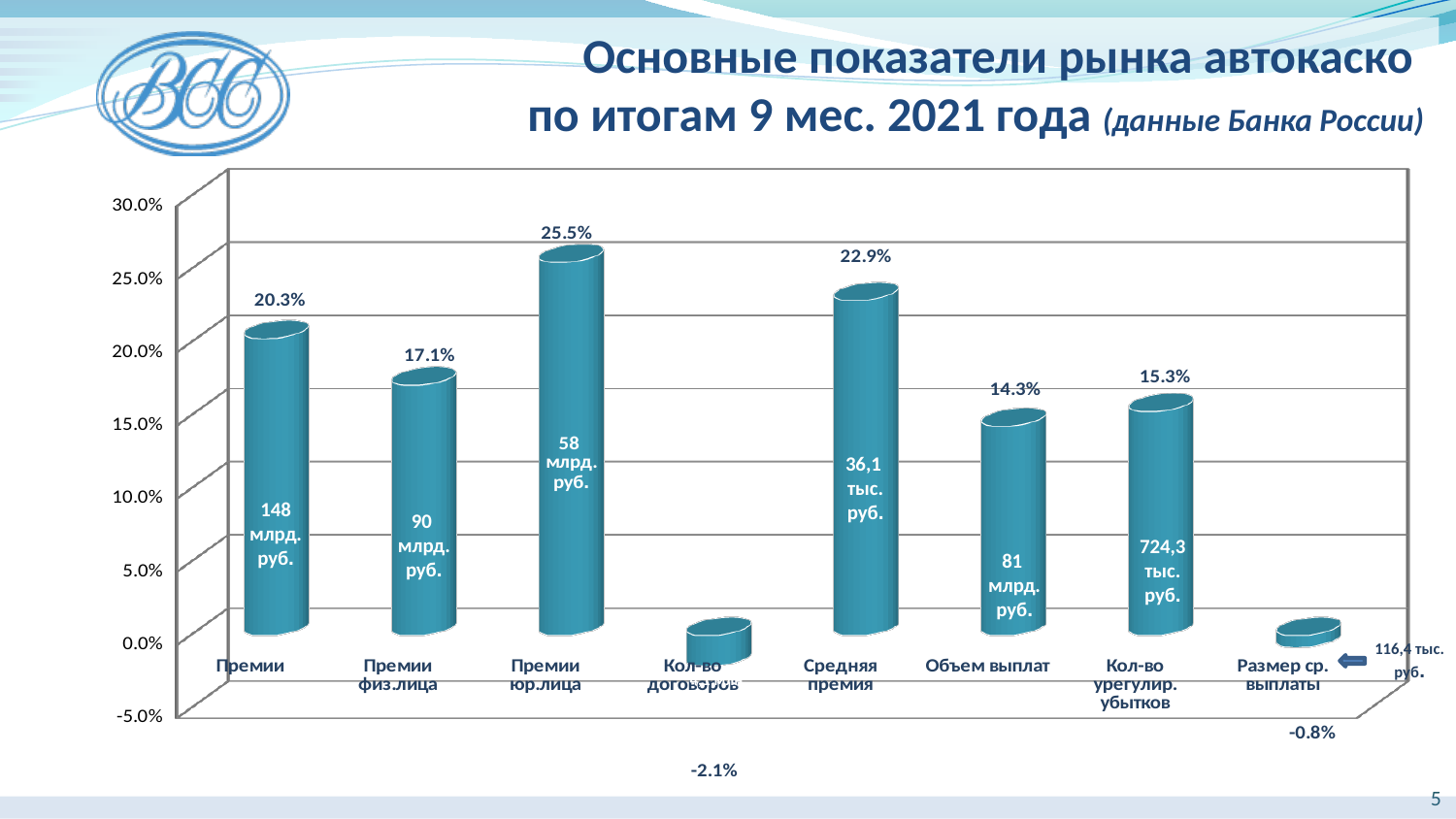
What is the difference between the growth values for Премии and Премии физ.лица? 3.2% How many categories are shown on the chart? 8 What absolute amount is printed inside the Премии bar? 148 млрд. руб. What absolute amount is printed inside the Кол-во урегулир. убытков bar? 724,3 тыс. руб. What is the growth value shown for Размер ср. выплаты? -0.8% What is the growth value shown for Премии юр.лица? 25.5% What is the growth value shown for Кол-во договоров? -2.1% Which category has the highest growth value? Премии юр.лица Which is larger, the growth value for Средняя премия or for Кол-во урегулир. убытков? Средняя премия What is the growth value shown for Объем выплат? 14.3% What kind of chart is shown on the slide? Bar chart Which category has the lowest growth value? Кол-во договоров